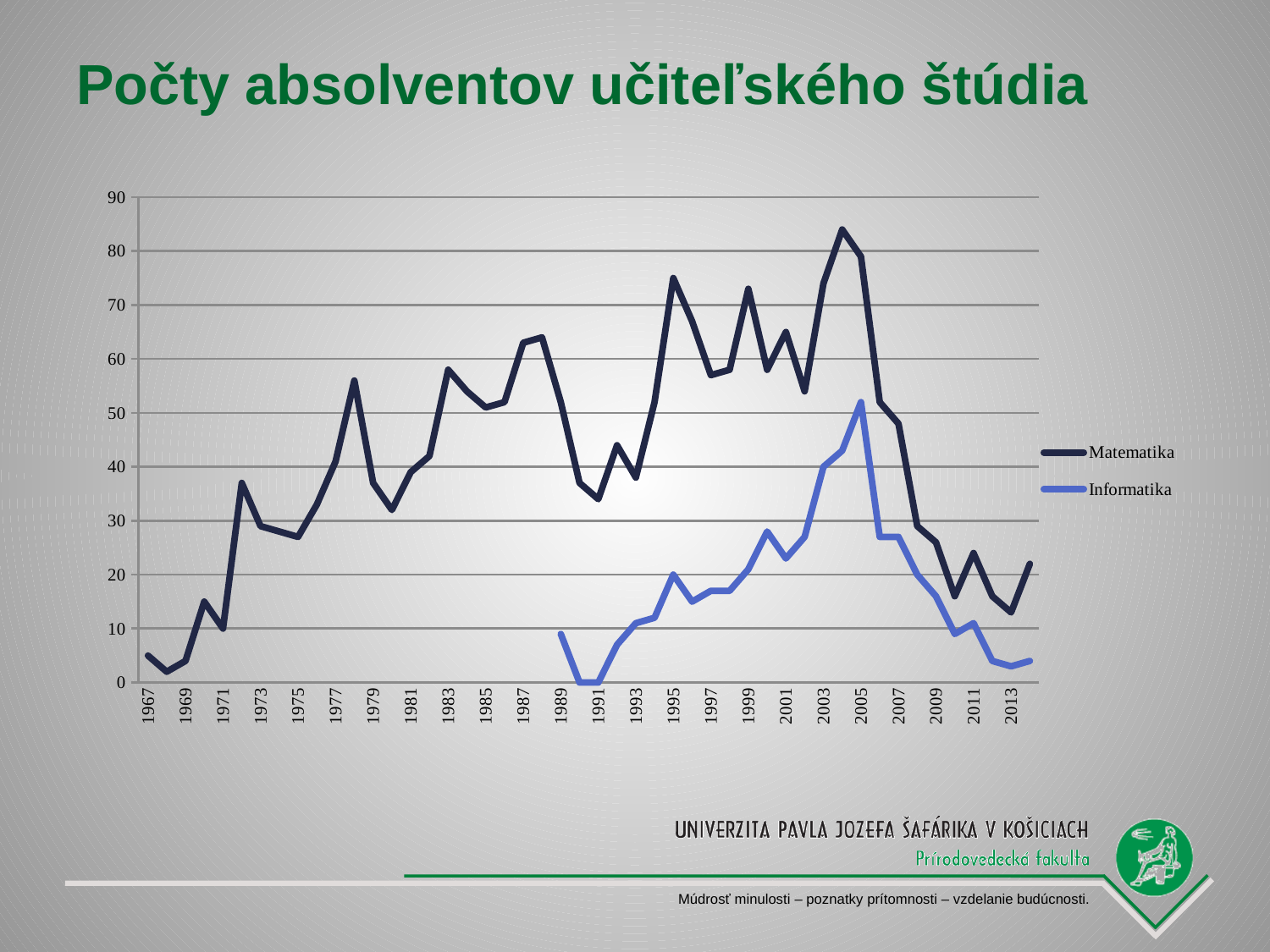
What is the title of the chart? Počty absolventov učiteľského štúdia In 1995, which series has the larger value, Matematika or Informatika? Matematika What kind of chart is shown on the slide? line chart In which year does the Matematika series reach its highest value? 2004 In which year does the Informatika series reach its highest value? 2005 Is the value for Matematika in 2004 greater or less than 80? greater Does the Matematika series overall rise or fall between 2005 and 2013? fall What are the two series named in the legend? Matematika and Informatika Which series reaches the higher peak value, Matematika or Informatika? Matematika Is the value for Matematika in 1967 greater or less than 10? less How many series does the legend list? 2 Is the value for Informatika in 2005 greater or less than 50? greater